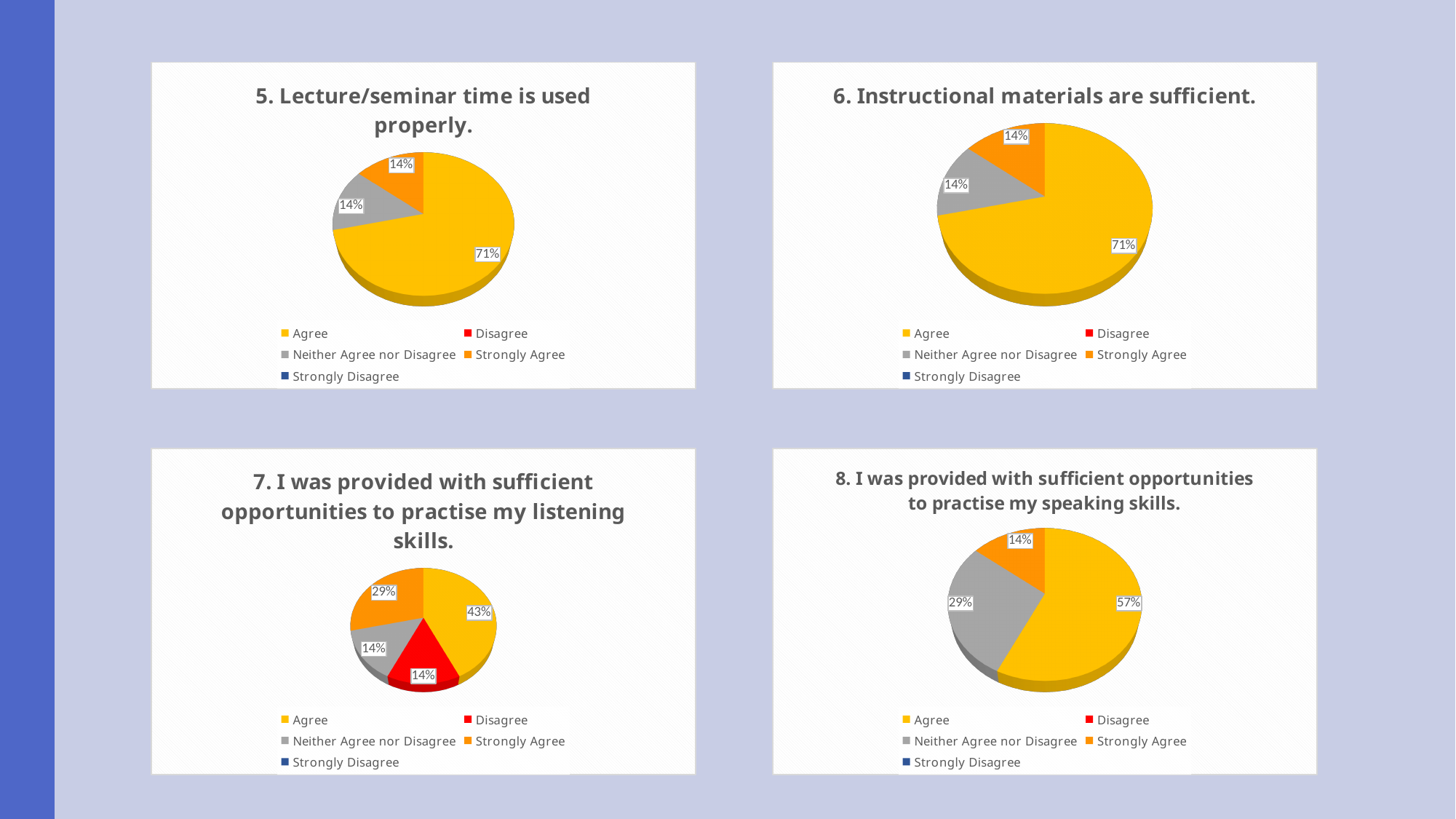
In the chart titled "5. Lecture/seminar time is used properly.", what share of responses is Agree? 71% How many entries does the legend list in the chart titled "5. Lecture/seminar time is used properly."? 5 In the chart titled "7. I was provided with sufficient opportunities to practise my listening skills.", what share of responses is Disagree? 14% How many slices are shown in the pie for "7. I was provided with sufficient opportunities to practise my listening skills."? 4 What kind of chart is used for "6. Instructional materials are sufficient."? Pie chart In the chart titled "7. I was provided with sufficient opportunities to practise my listening skills.", what share of responses is Strongly Agree? 29% In the chart titled "8. I was provided with sufficient opportunities to practise my speaking skills.", which response category has the largest slice? Agree In the chart titled "8. I was provided with sufficient opportunities to practise my speaking skills.", what is the difference between the Agree share and the Neither Agree nor Disagree share? 28% In the chart titled "7. I was provided with sufficient opportunities to practise my listening skills.", which is larger, the Agree slice or the Strongly Agree slice? Agree In the chart titled "6. Instructional materials are sufficient.", what share of responses is Neither Agree nor Disagree? 14% In the chart titled "7. I was provided with sufficient opportunities to practise my listening skills.", which response category has the largest slice? Agree In the chart titled "8. I was provided with sufficient opportunities to practise my speaking skills.", what share of responses is Agree? 57%